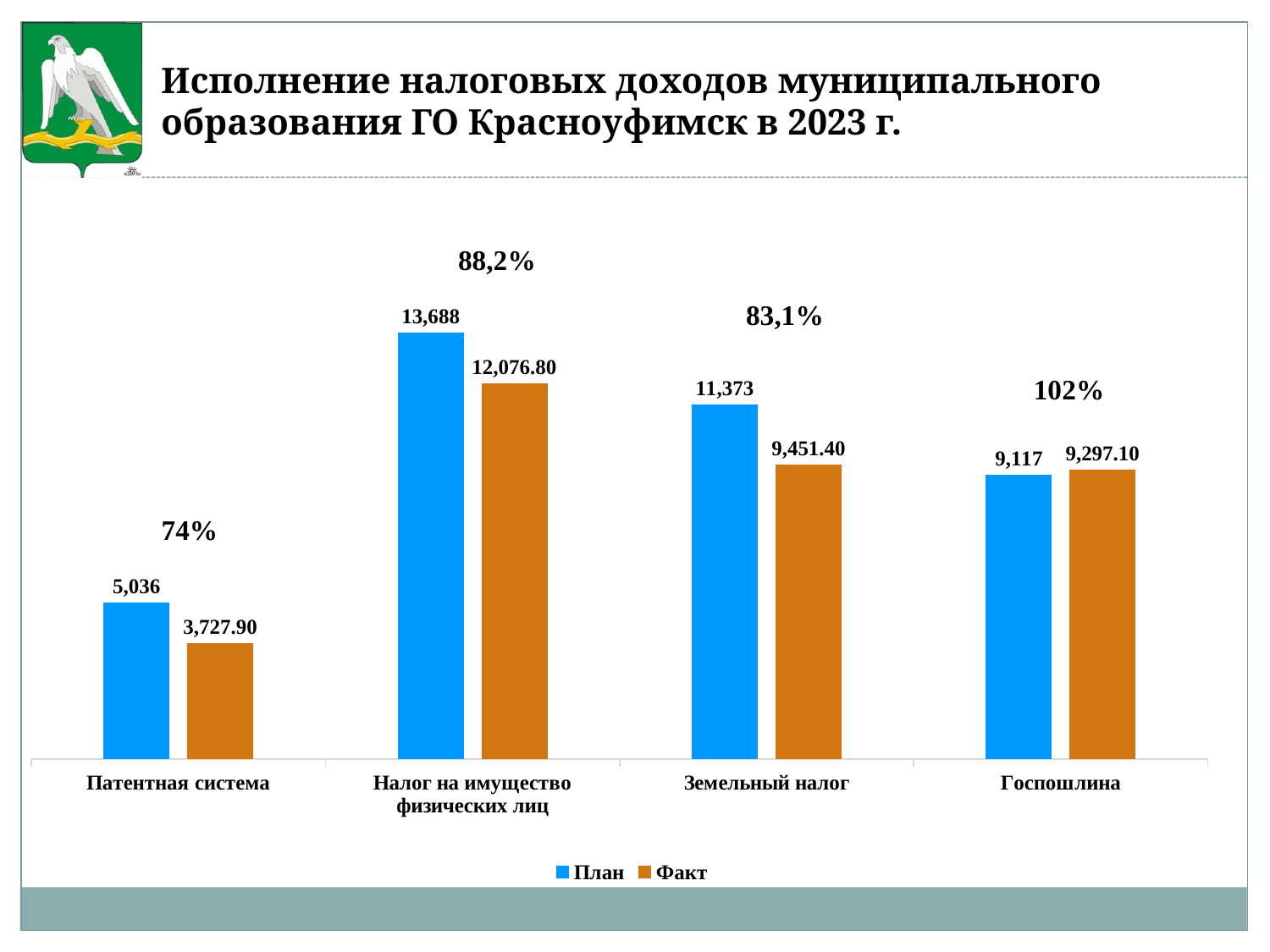
What is the План value for Патентная система? 5,036 What is the difference between the План and Факт values for Земельный налог? 1,921.60 What is the Факт value for Земельный налог? 9,451.40 Which category has the highest План value? Налог на имущество физических лиц How many categories are shown on the x axis? 4 What percentage is printed above the bars for Госпошлина? 102% How many series does the legend list? 2 What is the План value for Налог на имущество физических лиц? 13,688 What kind of chart is shown on the slide? Bar chart For Госпошлина, which is larger: the План value or the Факт value? Факт Which category has the lowest Факт value? Патентная система What is the Факт value for Госпошлина? 9,297.10